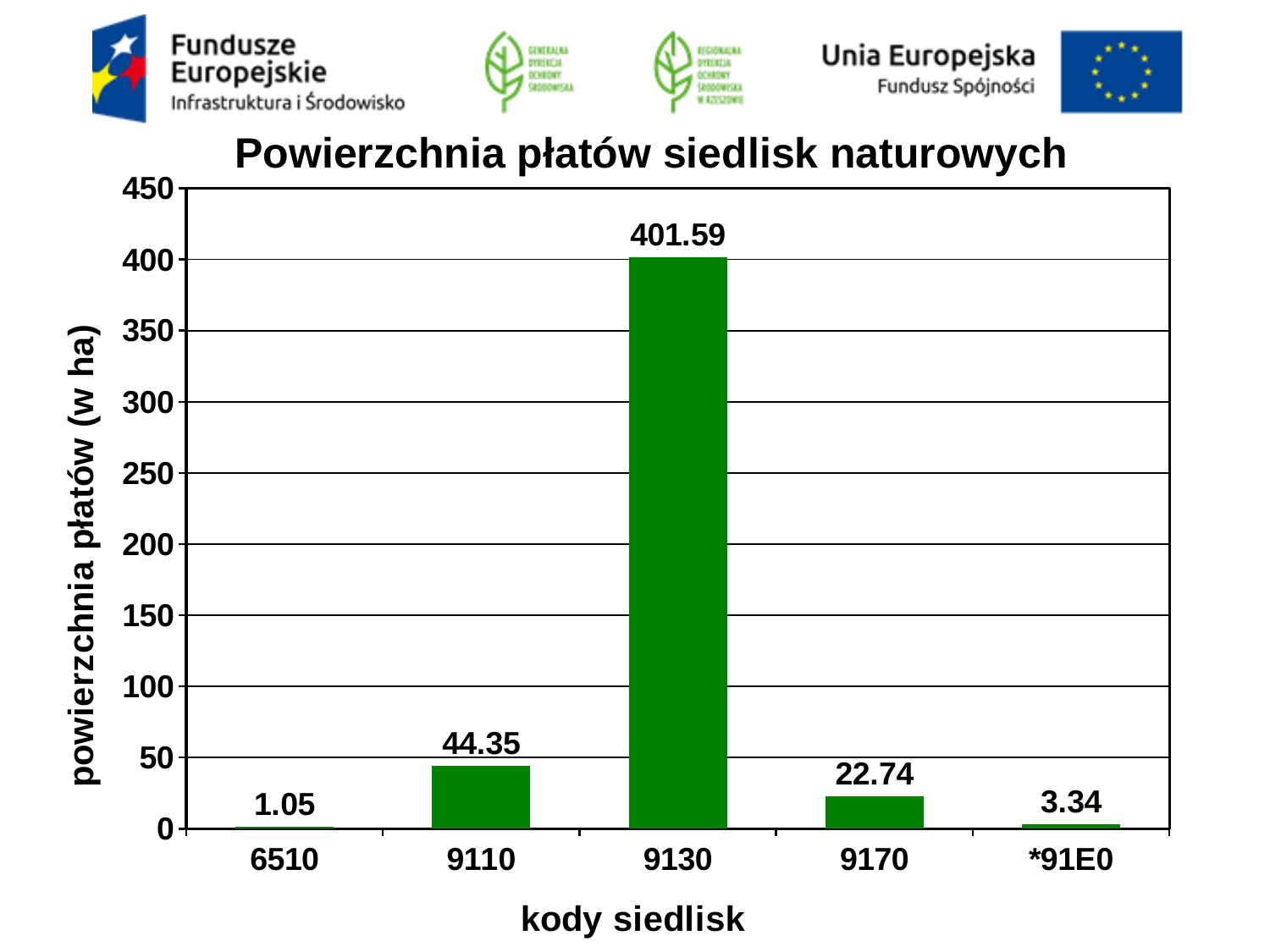
How many habitat codes are shown on the x axis? 5 What kind of chart is shown on the slide? bar chart What is the label of the y axis? powierzchnia płatów (w ha) What is the value for habitat code 6510? 1.05 What is the title of the chart? Powierzchnia płatów siedlisk naturowych Which habitat code has the highest value? 9130 Is the value for 9130 greater or less than 400? greater Which habitat code has the lowest value? 6510 What is the value for habitat code 9130? 401.59 What is the value for habitat code *91E0? 3.34 Which is larger, the value for 9170 or the value for *91E0? 9170 What is the difference between the values for 9110 and 9170? 21.61